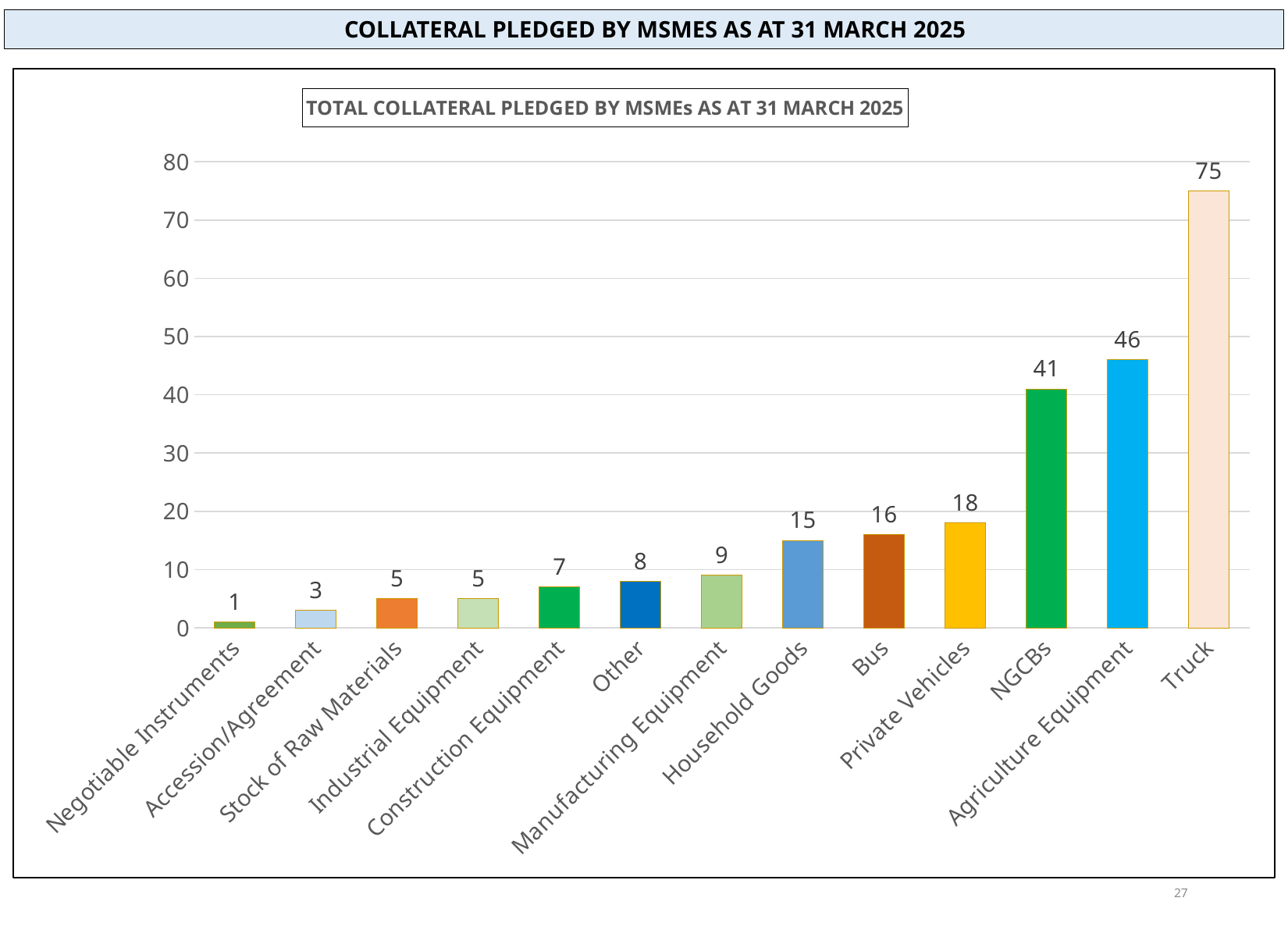
What kind of chart is shown? bar chart Which category has the lowest value? Negotiable Instruments What is the title of the chart? TOTAL COLLATERAL PLEDGED BY MSMEs AS AT 31 MARCH 2025 What is the difference between the values for Agriculture Equipment and NGCBs? 5 Which category has the highest value? Truck Is the value for Agriculture Equipment greater or less than 50? less What is the value for Truck? 75 What is the value for NGCBs? 41 Which is larger, the value for Bus or the value for Private Vehicles? Private Vehicles What is the value for Household Goods? 15 Do the values rise or fall from left to right along the x axis? rise How many categories are shown on the x axis? 13